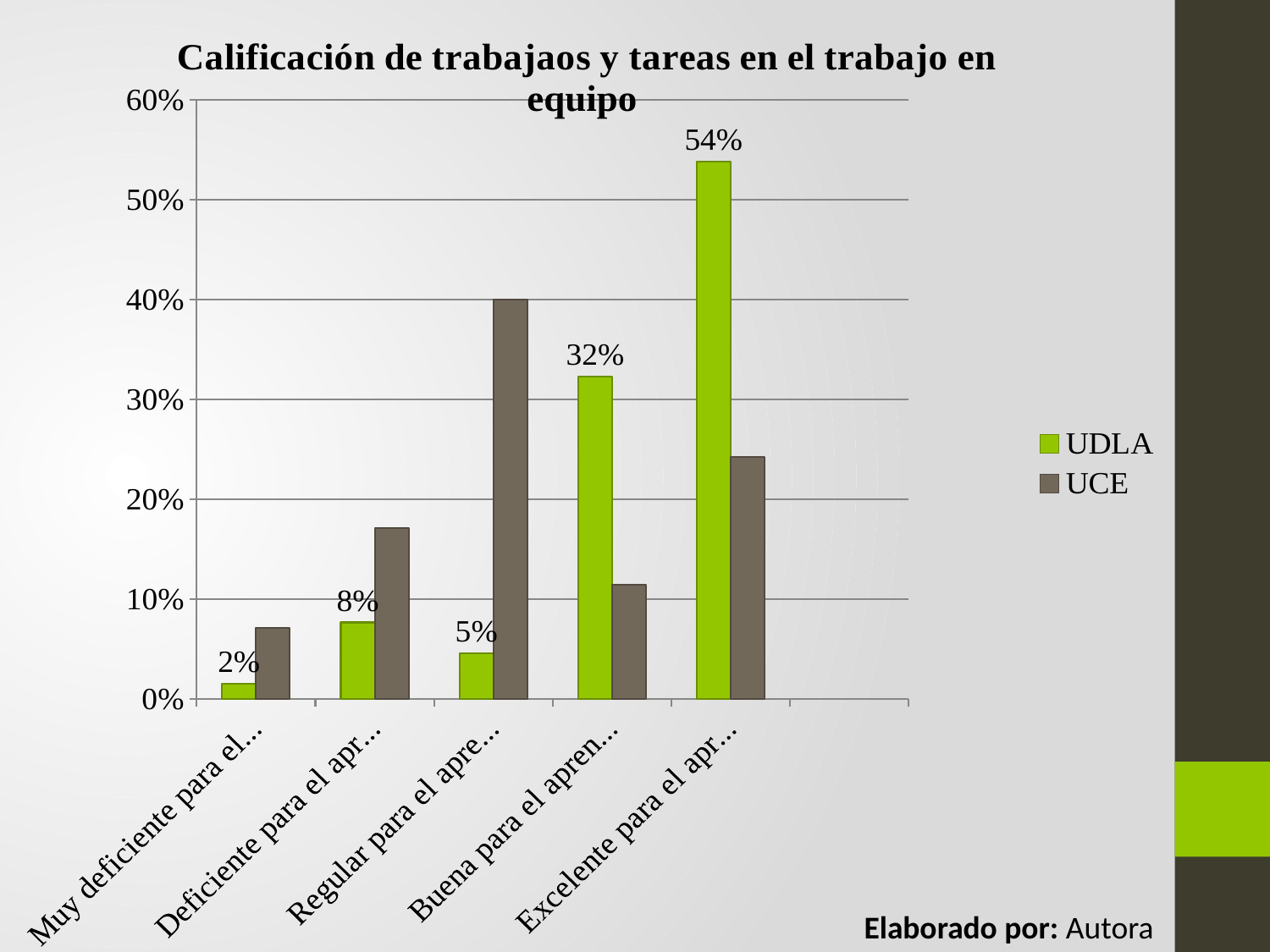
Which category has the highest UDLA value? Excelente In the "Regular" category, which series has the larger value, UDLA or UCE? UCE How many categories are shown on the x axis? 5 What is the UDLA value for the "Buena" category? 32% What is the difference between the UDLA values for "Excelente" and "Buena"? 22 percentage points In the "Buena" category, which series has the larger value, UDLA or UCE? UDLA Which category has the lowest UDLA value? Muy deficiente Is the UCE value for the "Deficiente" category greater or less than 20%? less Is the UCE value for the "Regular" category greater or less than 30%? greater What is the UDLA value for the "Excelente" category? 54% How many series does the legend list? 2 What is the UDLA value for the "Muy deficiente" category? 2%